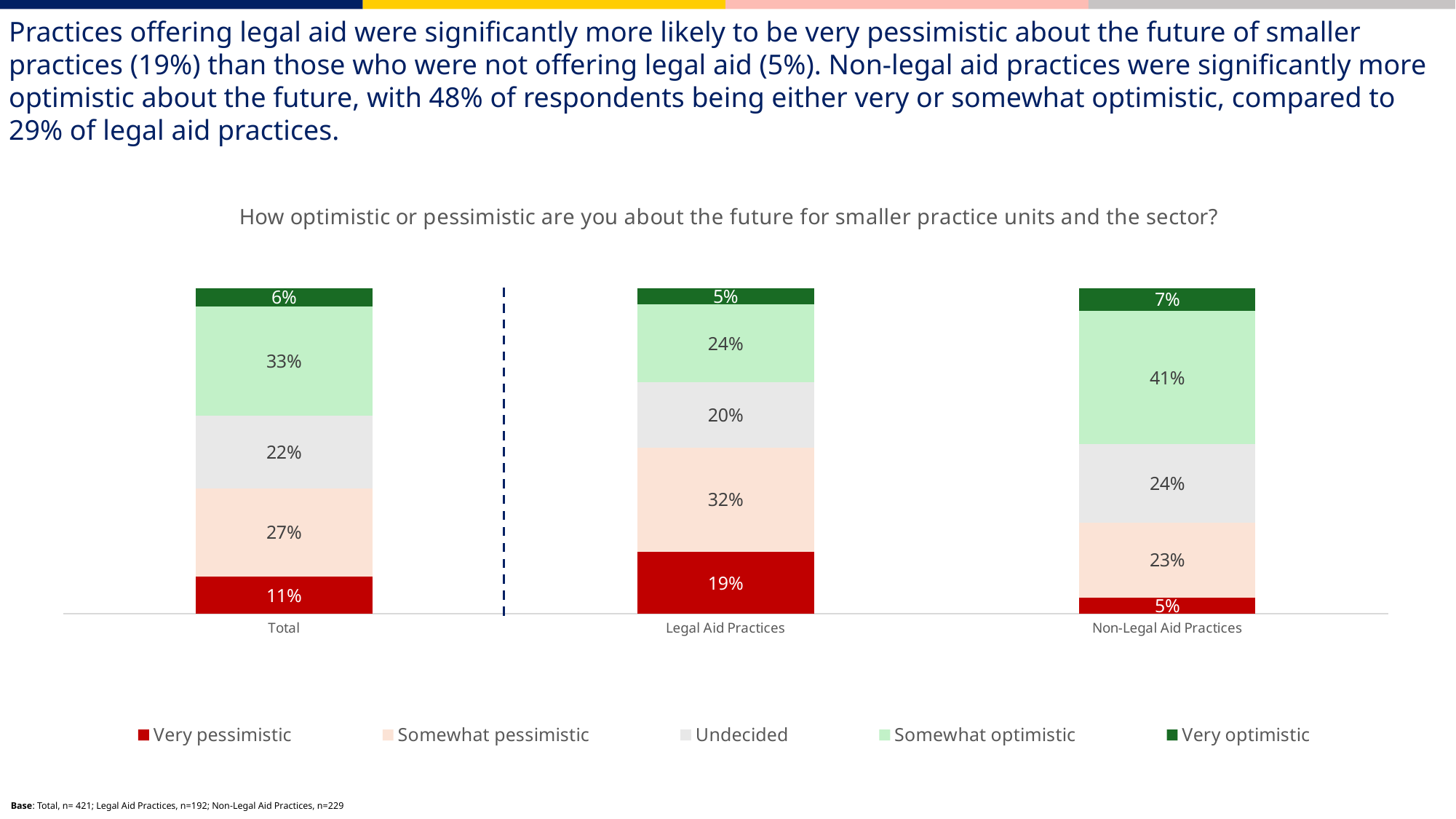
What is the Undecided value for Total? 22% Which is larger: the Undecided value for Legal Aid Practices or for Non-Legal Aid Practices? Non-Legal Aid Practices How many series does the legend list? 5 How many categories are shown on the x axis? 3 What is the difference between the Somewhat pessimistic values for Legal Aid Practices and Non-Legal Aid Practices? 9% What is the total of the stacked bar for Legal Aid Practices? 100% Which category has the lowest Somewhat optimistic value? Legal Aid Practices What kind of chart is shown on the slide? Stacked bar chart What is the Very optimistic value for Non-Legal Aid Practices? 7% Which category has the highest Very pessimistic value? Legal Aid Practices What is the Somewhat optimistic value for Non-Legal Aid Practices? 41% What is the Very pessimistic value for Legal Aid Practices? 19%